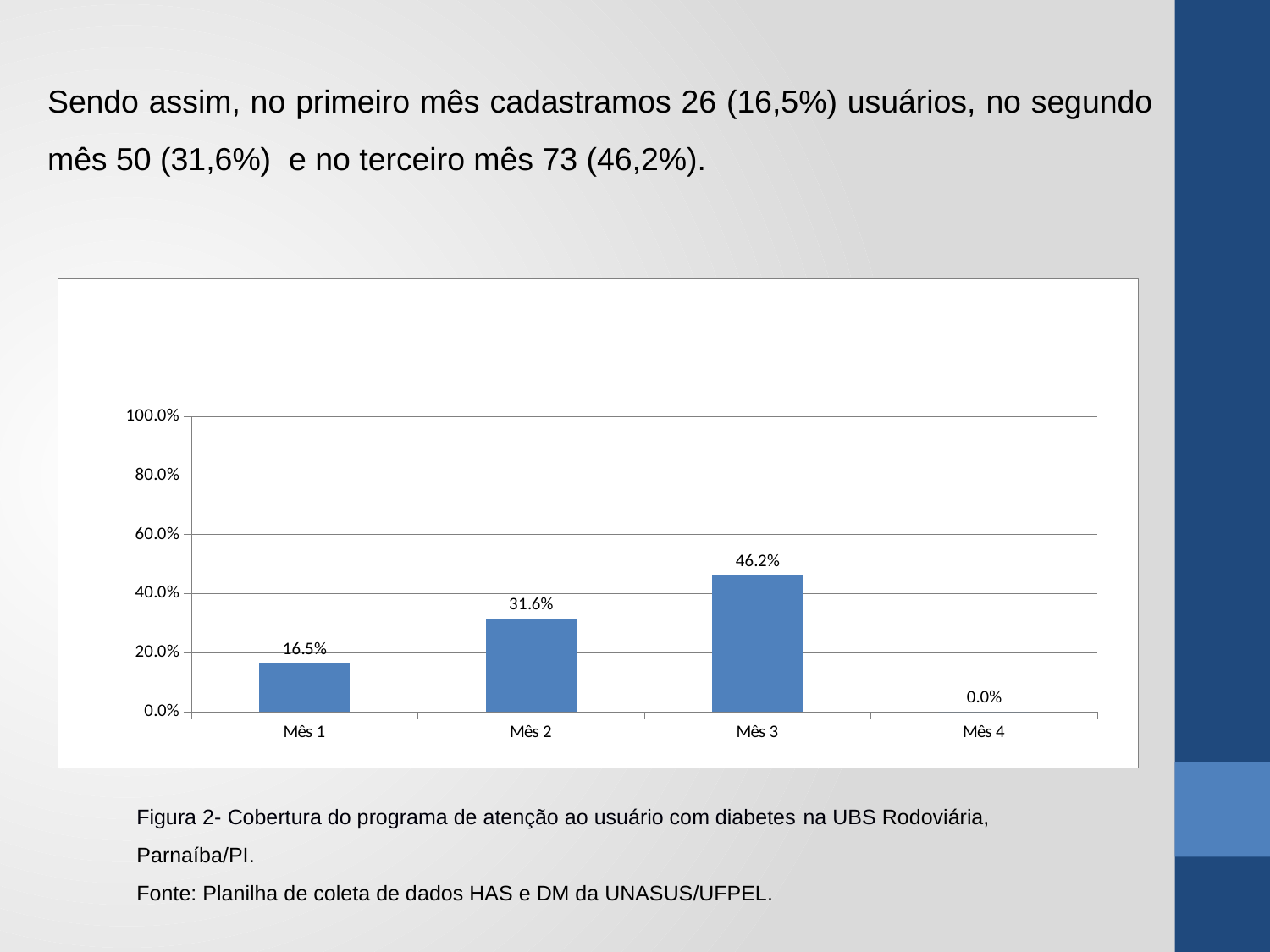
What kind of chart is shown on the slide? bar chart Is the value for Mês 3 greater or less than 40.0%? greater Do the values rise or fall from Mês 1 to Mês 3? rise What is the difference between the values for Mês 3 and Mês 2? 14.6% How many categories are shown on the x axis? 4 What is the value for Mês 1? 16.5% What is the value for Mês 4? 0.0% What is the value for Mês 2? 31.6% What is the value for Mês 3? 46.2% Which category has the lowest value? Mês 4 Which is larger, the value for Mês 1 or the value for Mês 2? Mês 2 Which category has the highest value? Mês 3